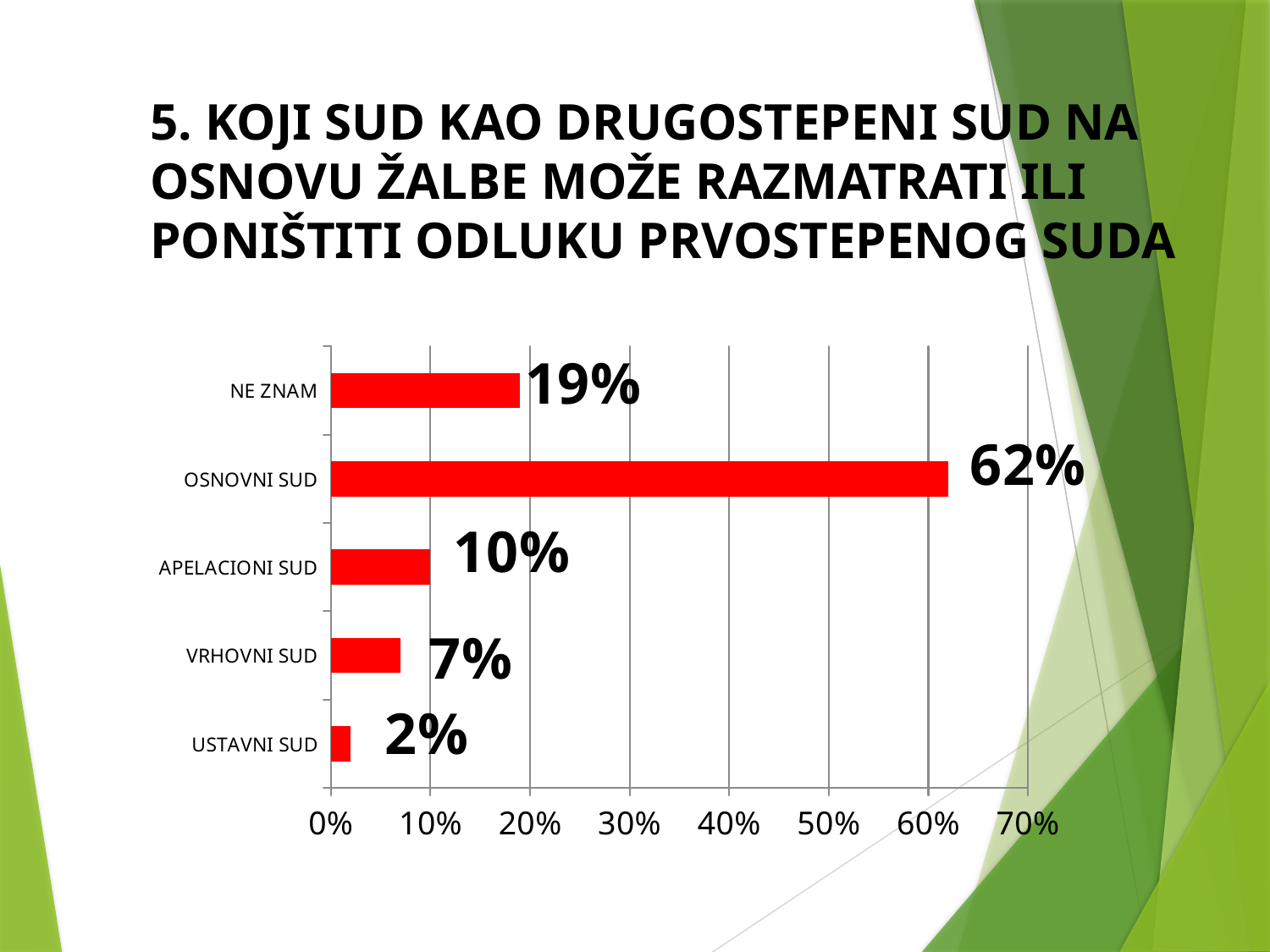
Which category has the highest value? OSNOVNI SUD Which is larger, the value for APELACIONI SUD or the value for VRHOVNI SUD? APELACIONI SUD What is the value for APELACIONI SUD? 10% Which category has the lowest value? USTAVNI SUD How many categories are shown in the chart? 5 What is the value for USTAVNI SUD? 2% Is the value for OSNOVNI SUD greater or less than 50%? greater What kind of chart is shown on the slide? bar chart What is the value for NE ZNAM? 19% What is the value for OSNOVNI SUD? 62% What is the difference between the values for OSNOVNI SUD and NE ZNAM? 43% What is the value for VRHOVNI SUD? 7%